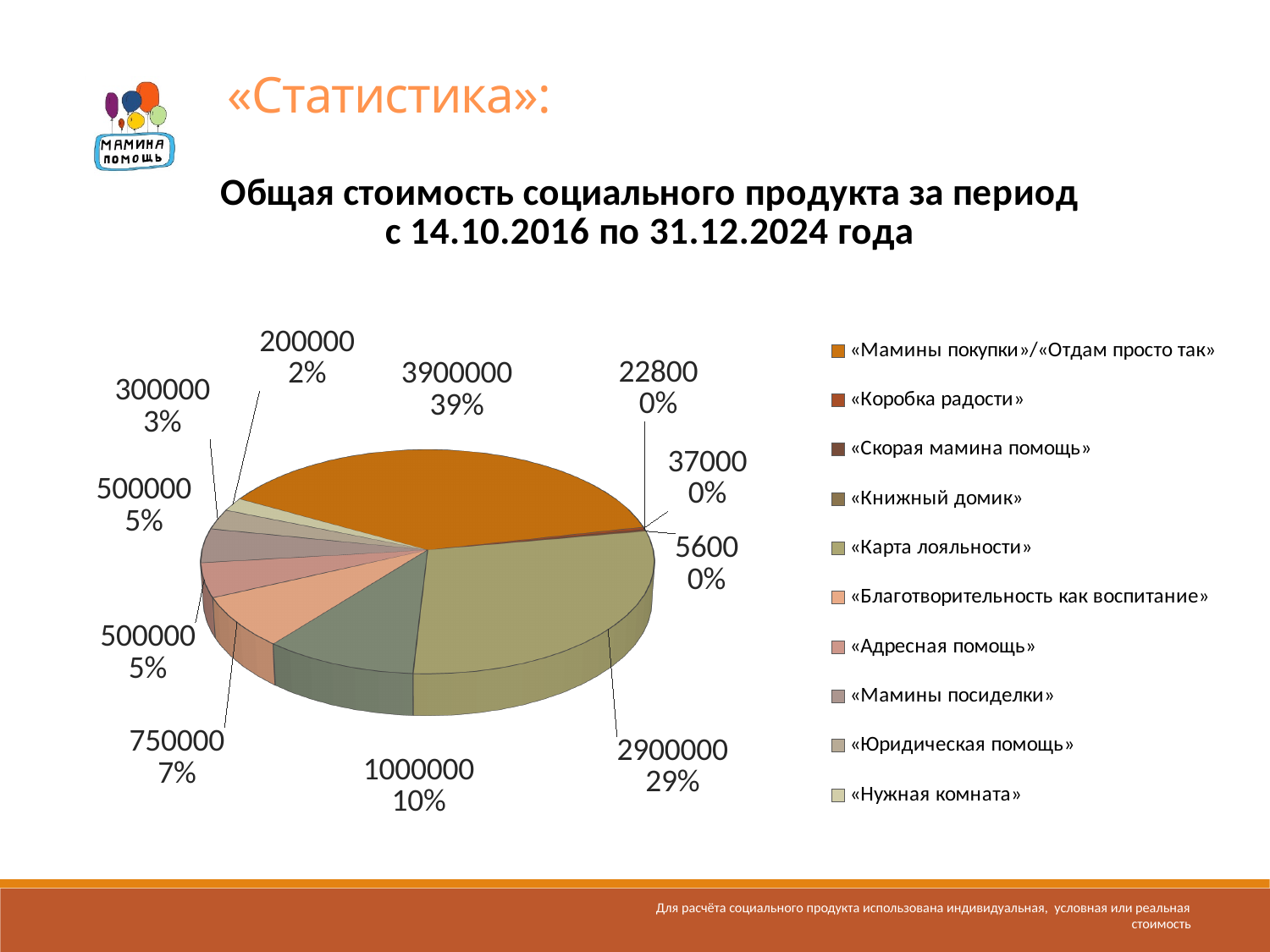
How many slices have data labels on the pie chart? 11 Which is larger: the slice labelled 750000 or the slice labelled 1000000? 1000000 What percentage share does the largest slice have? 39% What kind of chart is shown on the slide? Pie chart What share of the pie does the slice labelled 2900000 represent? 29% What is the value of the largest slice of the pie? 3900000 What is the value of the smallest slice of the pie? 5600 What is the value of the slice for «Мамины покупки»/«Отдам просто так»? 3900000 What is the difference between the two largest slices, 3900000 and 2900000? 1000000 What percentage share is shown for the slice labelled 300000? 3% What is the first entry listed in the chart legend? «Мамины покупки»/«Отдам просто так» What is the title of the chart? Общая стоимость социального продукта за период с 14.10.2016 по 31.12.2024 года